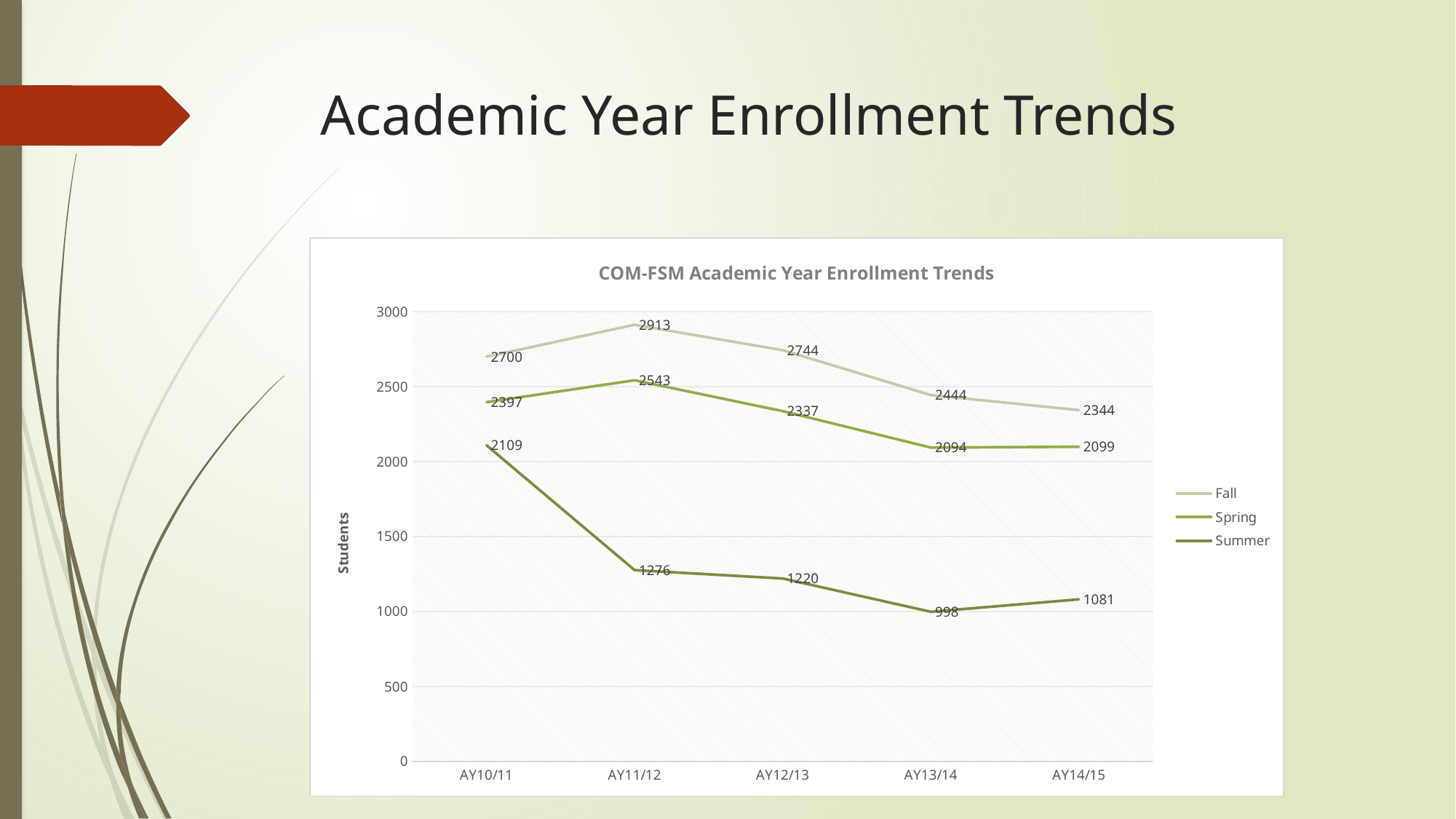
What kind of chart is shown? line chart What is the Fall enrollment for AY11/12? 2913 How many series does the legend list? 3 Is the Spring enrollment for AY12/13 greater or less than 2500? less In which academic year is Summer enrollment lowest? AY13/14 What is the Spring enrollment for AY14/15? 2099 What is the difference between Fall and Spring enrollment in AY10/11? 303 In which academic year is Fall enrollment highest? AY11/12 What is the title of the chart? COM-FSM Academic Year Enrollment Trends How many academic years are shown on the x axis? 5 Which is larger, Summer enrollment in AY12/13 or Summer enrollment in AY14/15? AY12/13 What is the Summer enrollment for AY13/14? 998